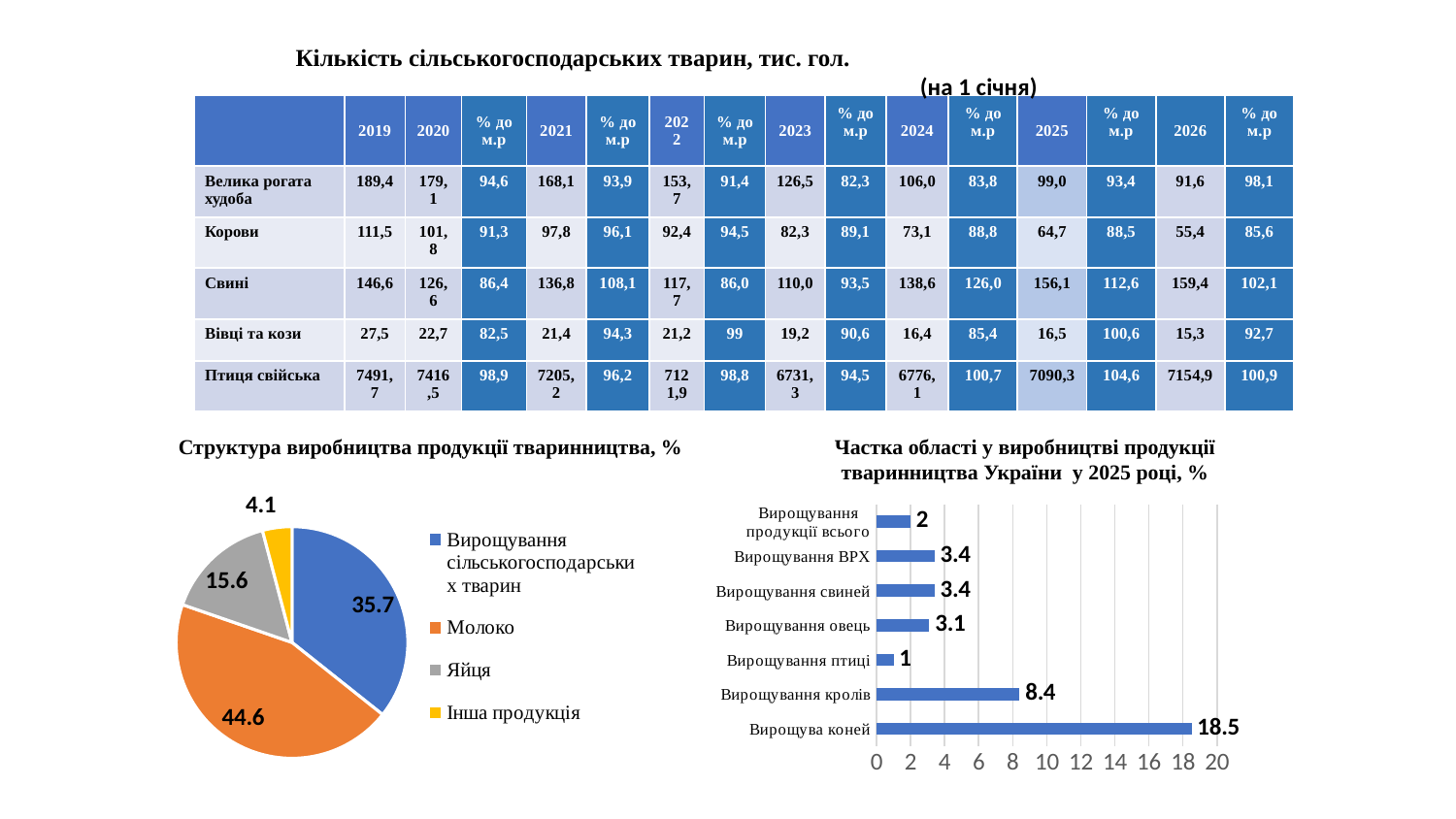
In the bar chart 'Частка області у виробництві продукції тваринництва України у 2025 році, %', what is the difference between the values for Вирощува коней and Вирощування кролів? 10.1 In the bar chart 'Частка області у виробництві продукції тваринництва України у 2025 році, %', which category has the highest value? Вирощува коней In the pie chart 'Структура виробництва продукції тваринництва, %', what is the difference between the values for Молоко and Вирощування сільськогосподарських тварин? 8.9 In the pie chart 'Структура виробництва продукції тваринництва, %', how many categories does the legend list? 4 In the pie chart 'Структура виробництва продукції тваринництва, %', which category has the smallest slice? Інша продукція In the bar chart 'Частка області у виробництві продукції тваринництва України у 2025 році, %', how many categories are plotted? 7 In the pie chart 'Структура виробництва продукції тваринництва, %', which category has the largest slice? Молоко In the bar chart 'Частка області у виробництві продукції тваринництва України у 2025 році, %', which category has the lowest value? Вирощування птиці In the pie chart 'Структура виробництва продукції тваринництва, %', what is the value for Молоко? 44.6 What type of chart is the one on the bottom right of the slide? Bar chart In the bar chart 'Частка області у виробництві продукції тваринництва України у 2025 році, %', what is the value for Вирощування кролів? 8.4 In the pie chart 'Структура виробництва продукції тваринництва, %', what is the value for Яйця? 15.6